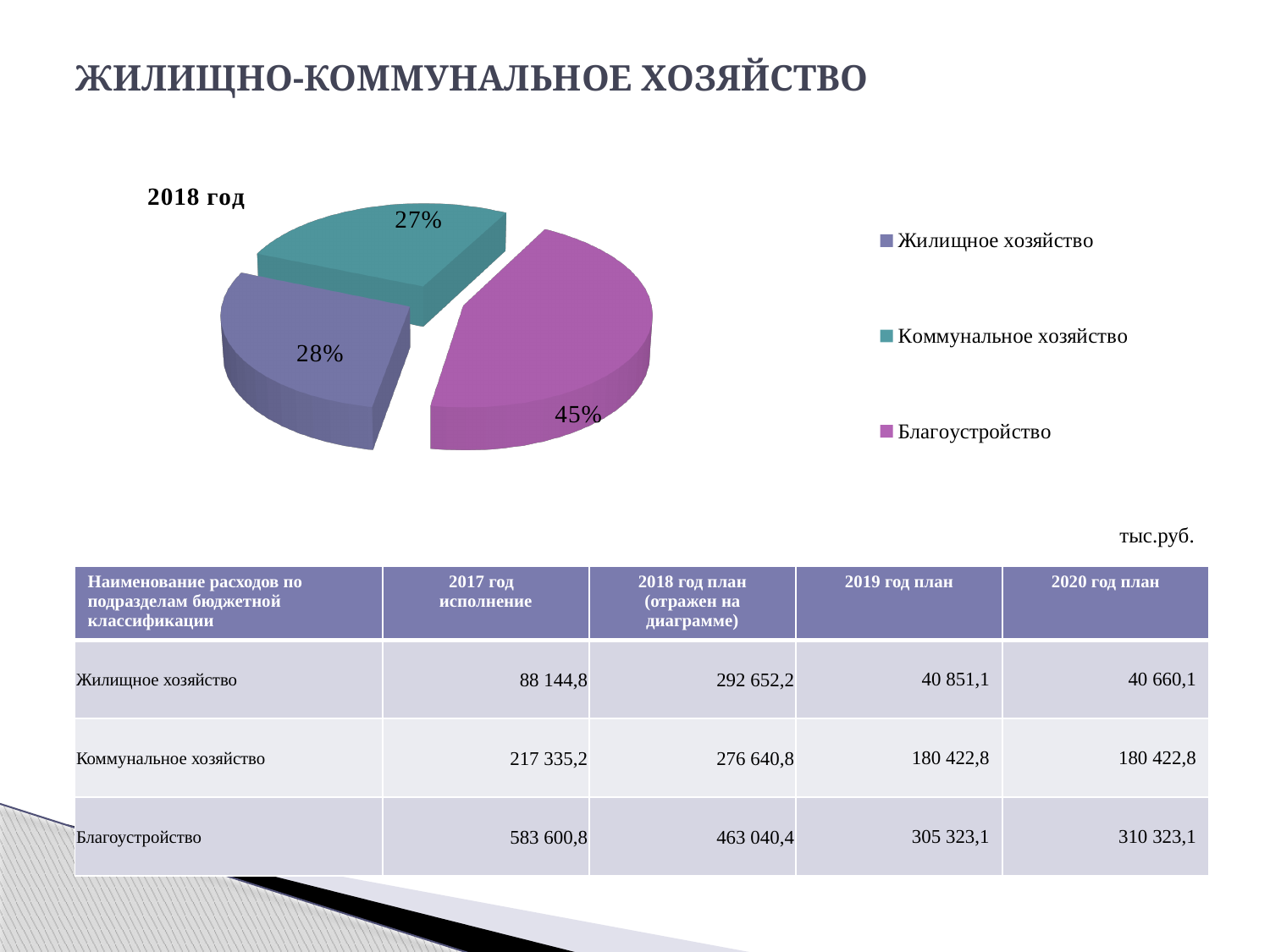
Which slice is larger, Жилищное хозяйство or Коммунальное хозяйство? Жилищное хозяйство What colour is the Благоустройство slice in the pie chart? Magenta (pink-purple) What is the title of the pie chart? 2018 год What share of the pie does Жилищное хозяйство have? 28% Which category has the largest slice of the pie? Благоустройство What kind of chart is shown on the slide? Pie chart What share of the pie does Коммунальное хозяйство have? 27% What share of the pie does Благоустройство have? 45% Which category has the smallest slice of the pie? Коммунальное хозяйство By how many percentage points does the Благоустройство slice exceed the Жилищное хозяйство slice? 17 percentage points How many slices does the pie chart have? 3 How many entries does the chart legend list? 3